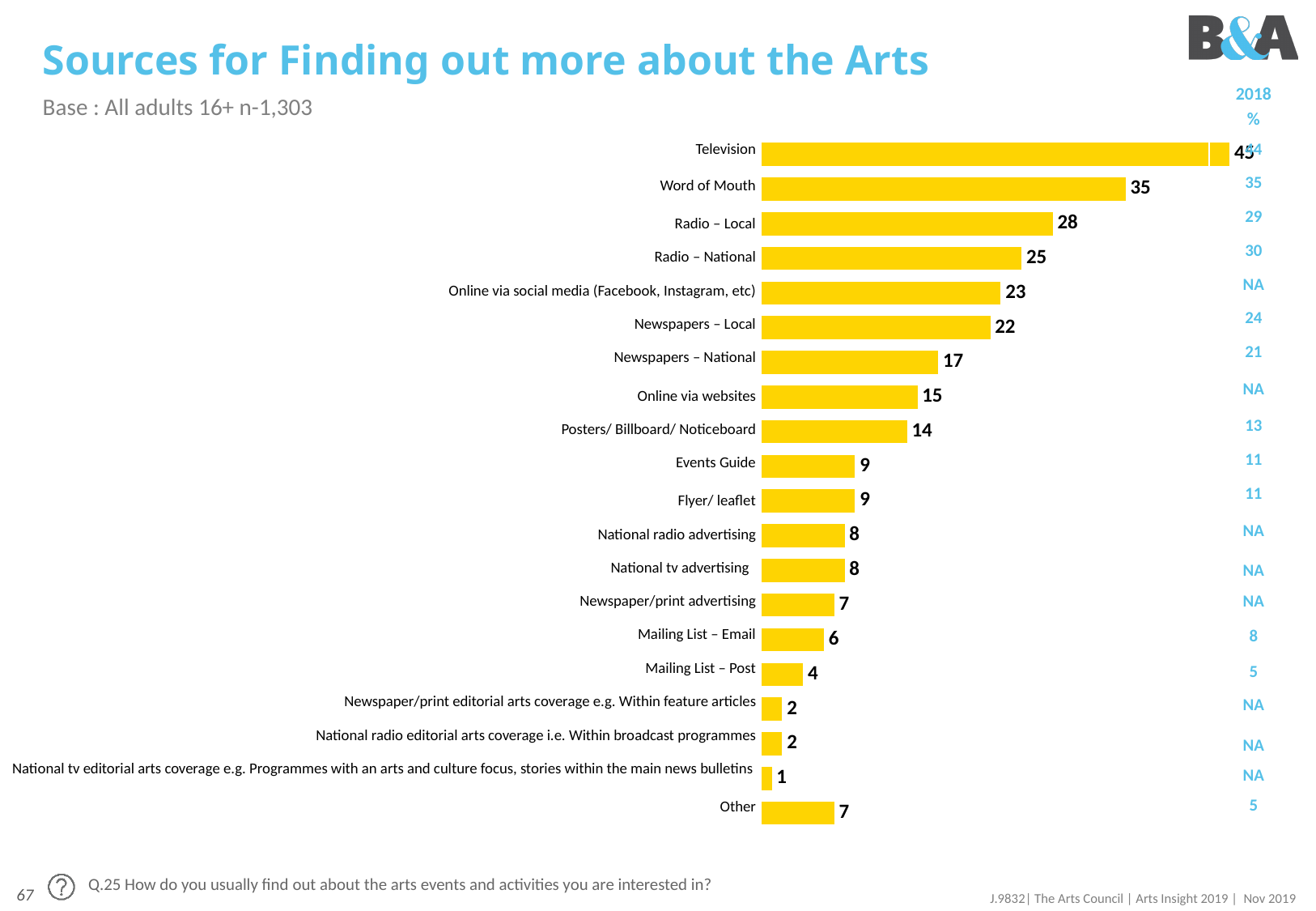
What is the title of the slide? Sources for Finding out more about the Arts What is the value for Posters/ Billboard/ Noticeboard? 14 What is the difference between the values for Word of Mouth and Radio – National? 10 What is the value for Online via social media (Facebook, Instagram, etc)? 23 What is the value for Radio – Local? 28 How many sources (categories) are plotted in the chart? 20 Which source has the highest value in the chart? Television What is the value for Mailing List – Post? 4 Which source has the lowest value in the chart? National tv editorial arts coverage e.g. Programmes with an arts and culture focus, stories within the main news bulletins Which is larger, the value for Newspapers – Local or the value for Newspapers – National? Newspapers – Local What is the value for Word of Mouth? 35 What kind of chart is shown on the slide? bar chart